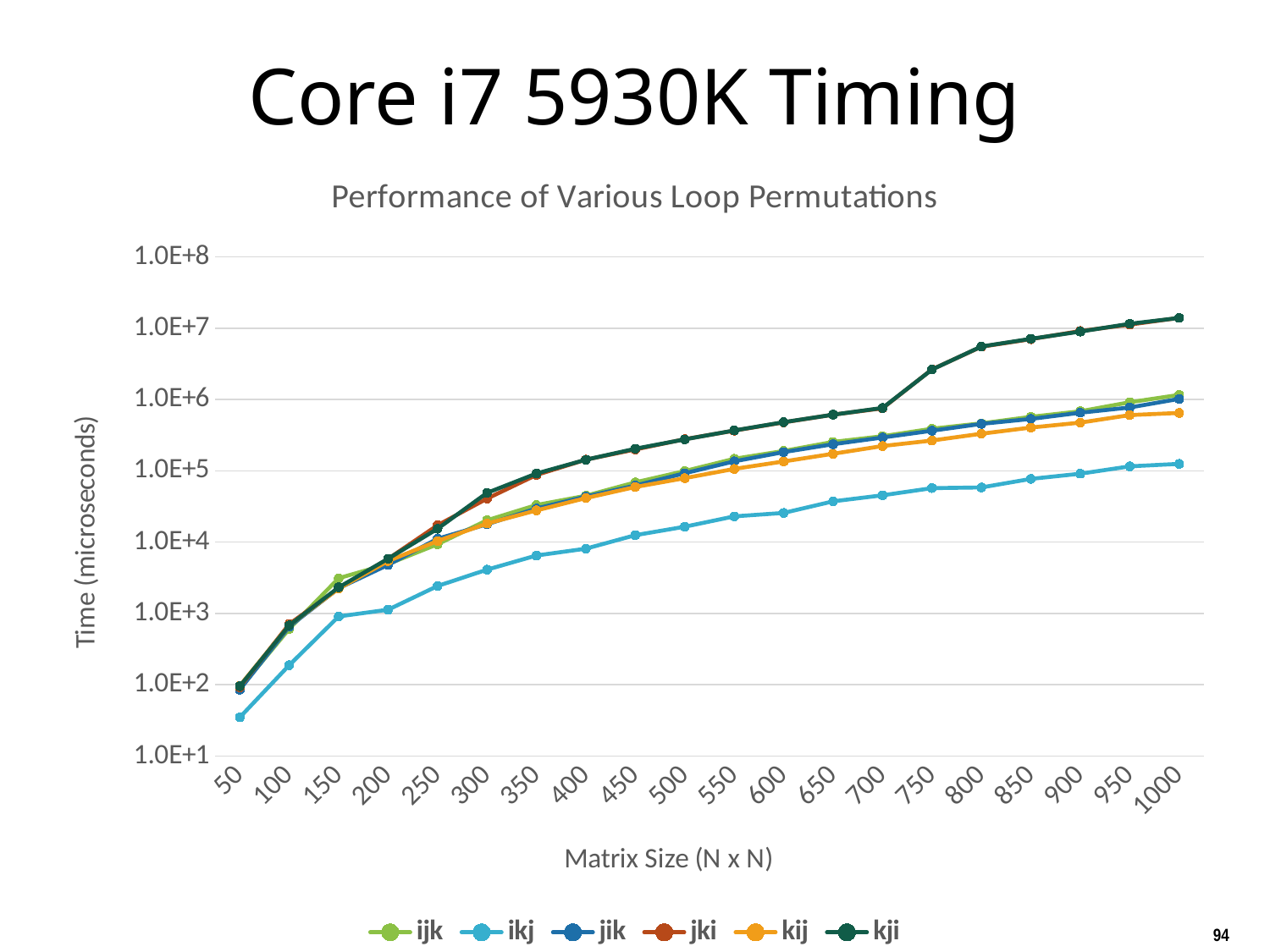
At matrix size 800, which has the larger time, kji or ikj? kji Is the time for kji at matrix size 800 greater or less than 1.0E+6 microseconds? greater What kind of chart is shown on the slide? line chart Is the time for kji at matrix size 700 greater or less than 1.0E+6 microseconds? less What is the title of the chart? Performance of Various Loop Permutations Is the time for kji at matrix size 1000 greater or less than 1.0E+7 microseconds? greater Do the times for the ikj series rise or fall as matrix size increases? rise How many series does the legend list? 6 Which loop permutation has the lowest time at matrix size 1000? ikj How many matrix sizes are plotted along the x axis? 20